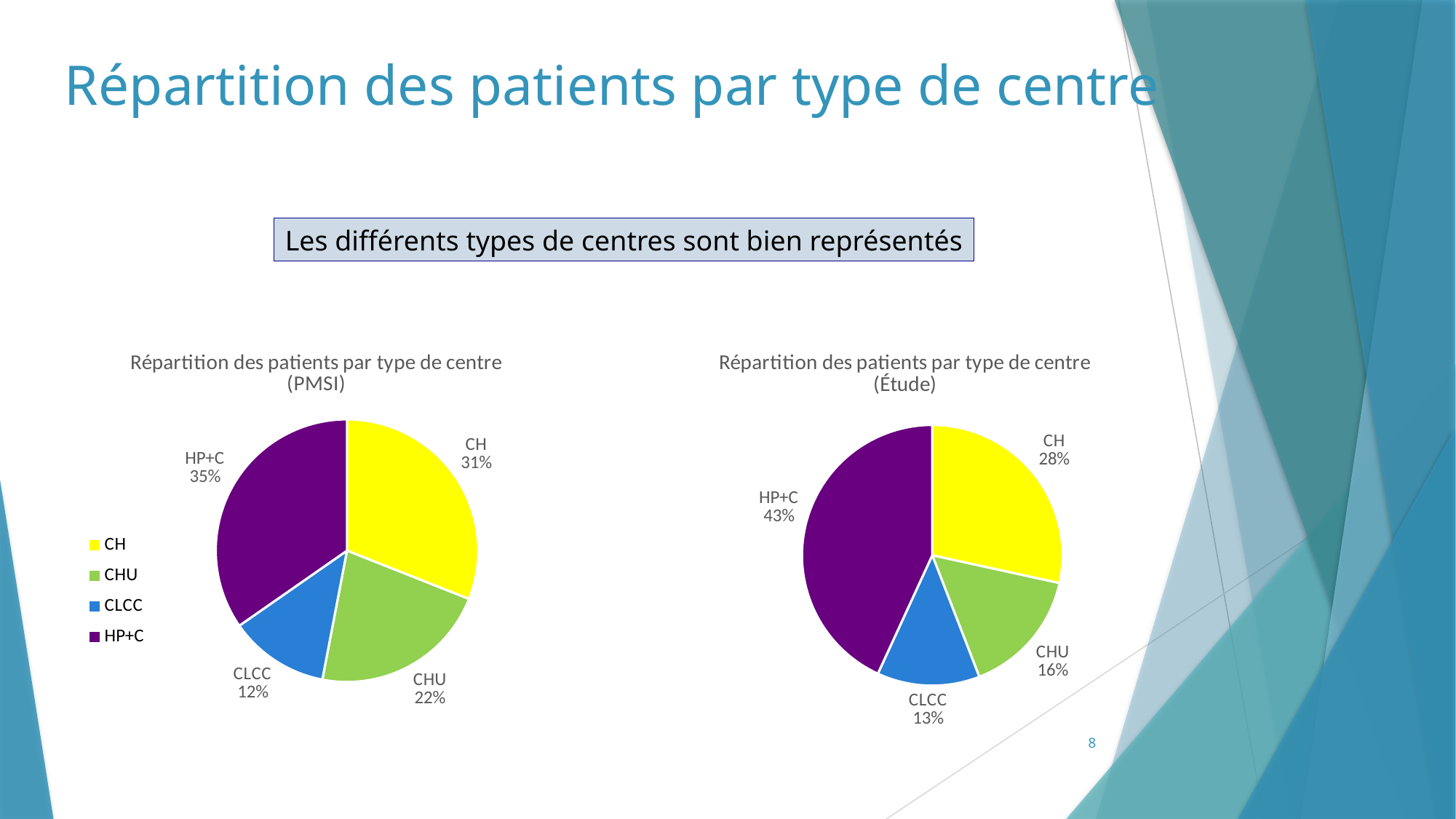
How many entries does the legend of the 'Répartition des patients par type de centre (PMSI)' chart list? 4 In the 'Répartition des patients par type de centre (Étude)' chart, which is larger, the CHU share or the CH share? CH In the 'Répartition des patients par type de centre (Étude)' chart, which type of centre has the smallest share? CLCC In the 'Répartition des patients par type de centre (PMSI)' chart, what share of patients is in CHU? 22% What kind of chart is the 'Répartition des patients par type de centre (Étude)' chart? Pie chart In the 'Répartition des patients par type de centre (PMSI)' chart, what colour is the HP+C slice? Purple In the 'Répartition des patients par type de centre (PMSI)' chart, what share of patients is in CH? 31% In the 'Répartition des patients par type de centre (PMSI)' chart, what is the difference between the CH share and the CLCC share? 19% In the 'Répartition des patients par type de centre (PMSI)' chart, which type of centre has the largest share? HP+C In the 'Répartition des patients par type de centre (Étude)' chart, what share of patients is in CLCC? 13% How many slices does the 'Répartition des patients par type de centre (PMSI)' pie chart have? 4 In the 'Répartition des patients par type de centre (Étude)' chart, what share of patients is in HP+C? 43%